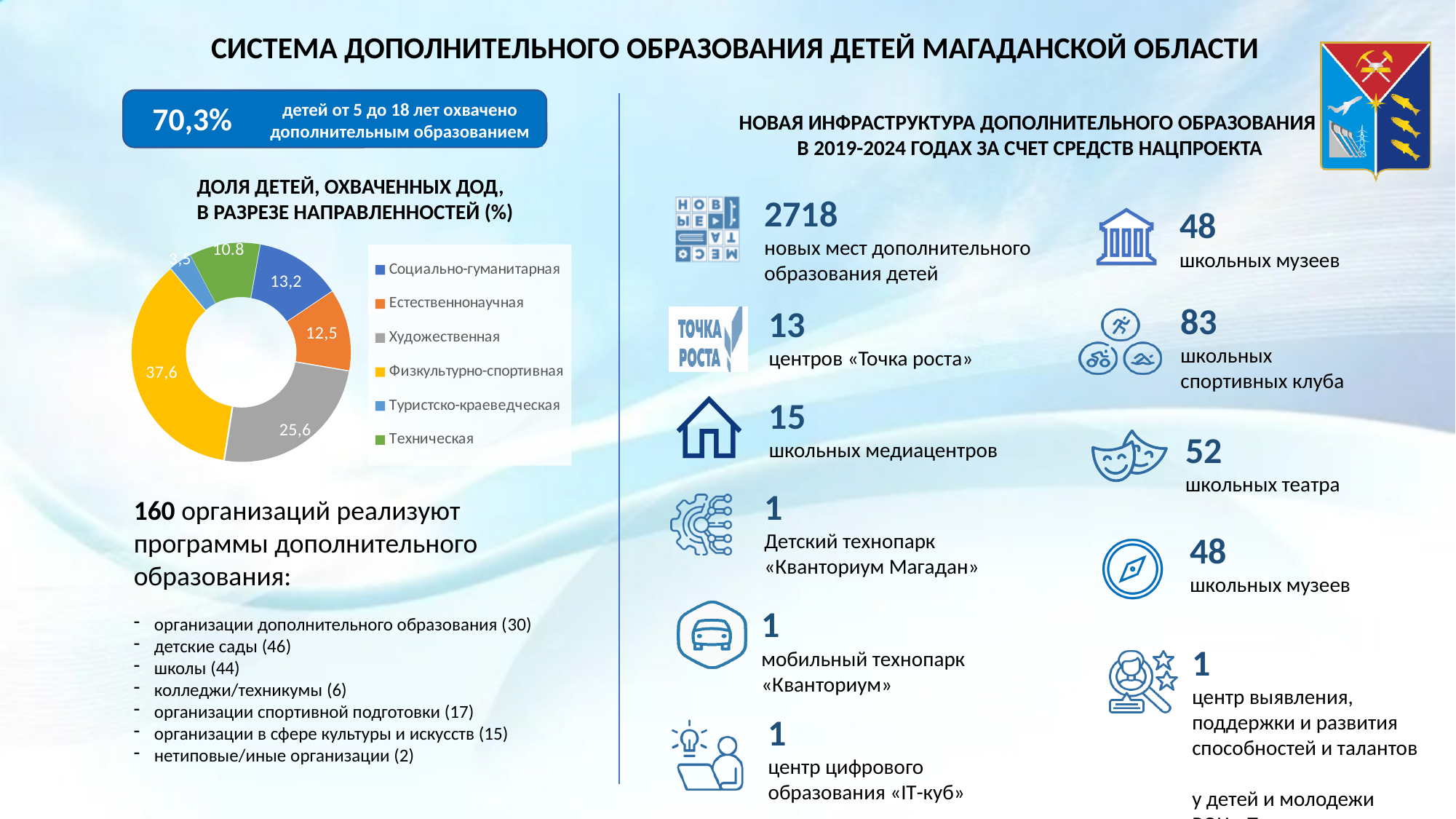
What is the value for Художественная in the doughnut chart? 25,6 How many categories does the doughnut chart show? 6 What is the difference between the values for Физкультурно-спортивная and Художественная in the doughnut chart? 12 In the doughnut chart, which is larger: Социально-гуманитарная or Естественнонаучная? Социально-гуманитарная What is the difference between the values for Социально-гуманитарная and Естественнонаучная in the doughnut chart? 0,7 What is the value for Туристско-краеведческая in the doughnut chart? 3,5 Which category has the largest share in the doughnut chart? Физкультурно-спортивная What is the value for Техническая in the doughnut chart? 10,8 What colour represents Физкультурно-спортивная in the doughnut chart legend? Yellow What is the value for Физкультурно-спортивная in the doughnut chart? 37,6 Which category has the smallest share in the doughnut chart? Туристско-краеведческая What type of chart is shown under the title "ДОЛЯ ДЕТЕЙ, ОХВАЧЕННЫХ ДОД, В РАЗРЕЗЕ НАПРАВЛЕННОСТЕЙ (%)"? Doughnut (pie) chart